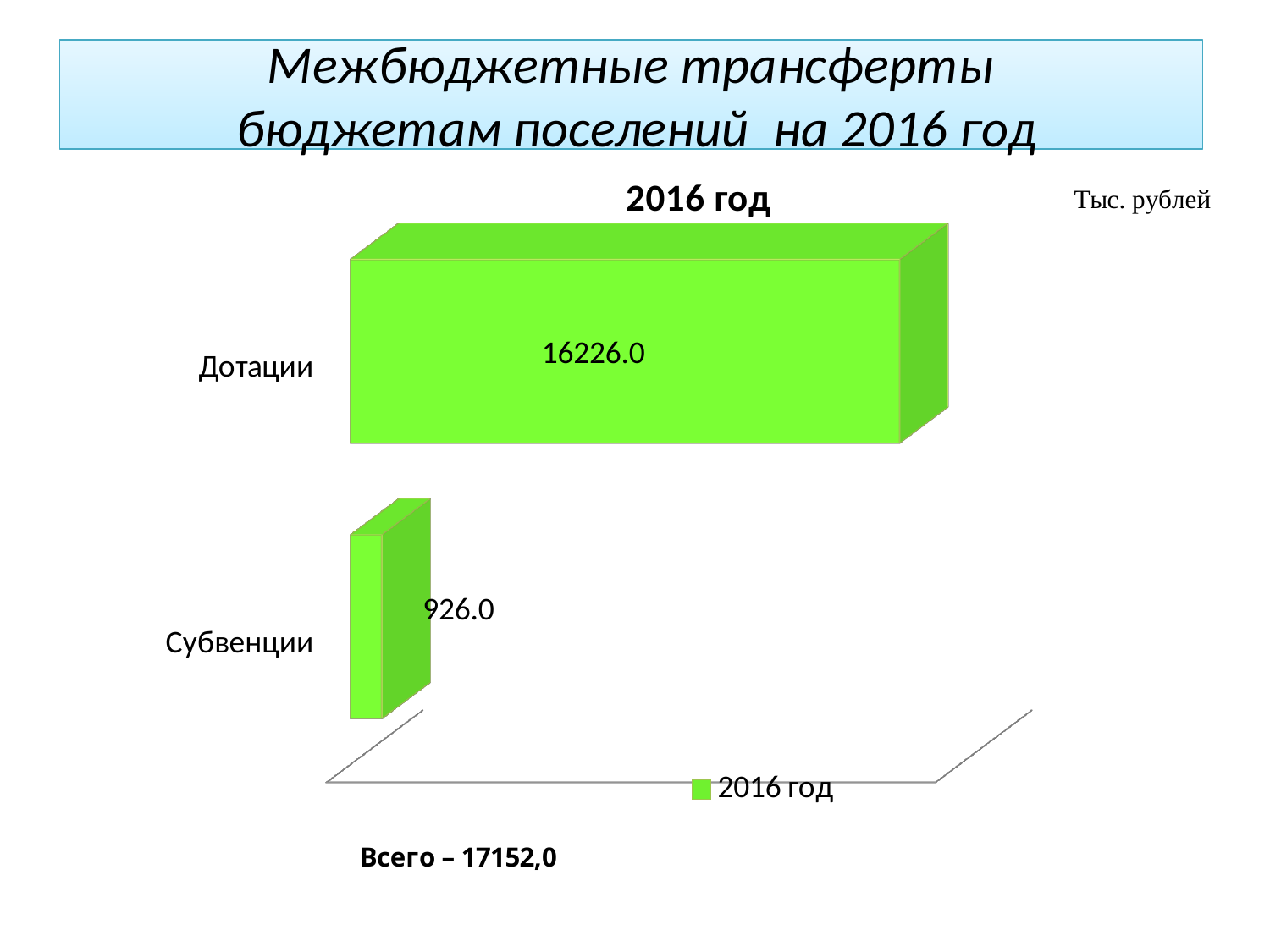
Which category has the highest value? Дотации What is the value for Дотации? 16226.0 Which category has the lowest value? Субвенции What is the difference between the values for Дотации and Субвенции? 15300.0 What kind of chart is shown on the slide? bar chart Which is larger, the value for Дотации or the value for Субвенции? Дотации How many series does the legend list? 1 What is the title of the chart? 2016 год What series name is shown in the legend? 2016 год How many categories are shown in the chart? 2 What is the total of the two categories shown in the chart? 17152.0 What is the value for Субвенции? 926.0